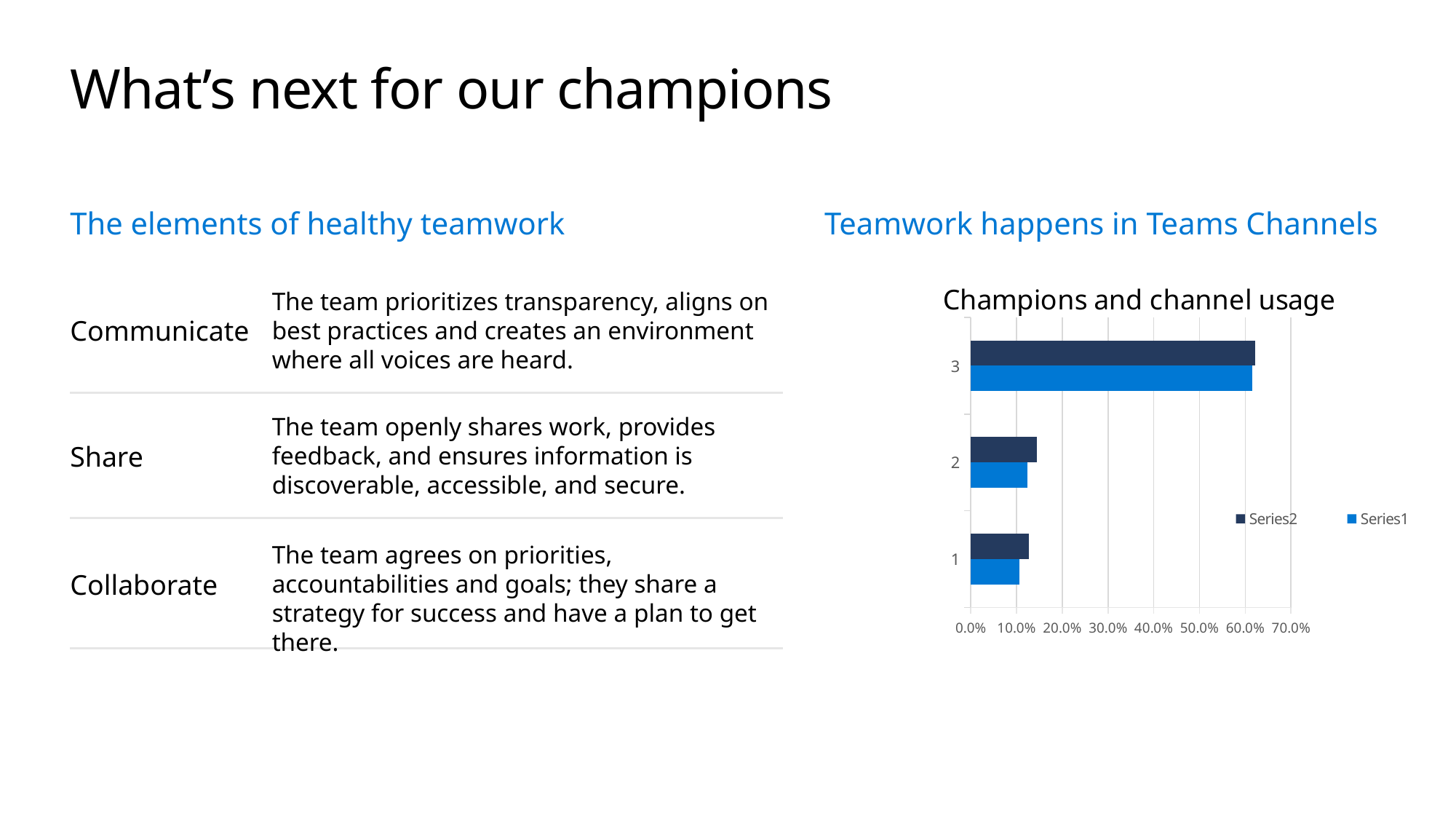
Which series is shown in the lighter blue colour in the chart? Series1 Which category has the highest value for Series1? 3 Is the Series2 value for category 3 greater or less than 50.0%? greater For Series1, which category has the larger value, 2 or 3? 3 What kind of chart is shown on the slide? bar chart Which category has the lowest value for Series1? 1 Is the Series2 value for category 2 greater or less than 10.0%? greater How many categories are shown on the chart's vertical axis? 3 Which category has the highest value for Series2? 3 What is the title of the chart? Champions and channel usage How many series does the chart legend list? 2 Is the Series1 value for category 1 greater or less than 20.0%? less